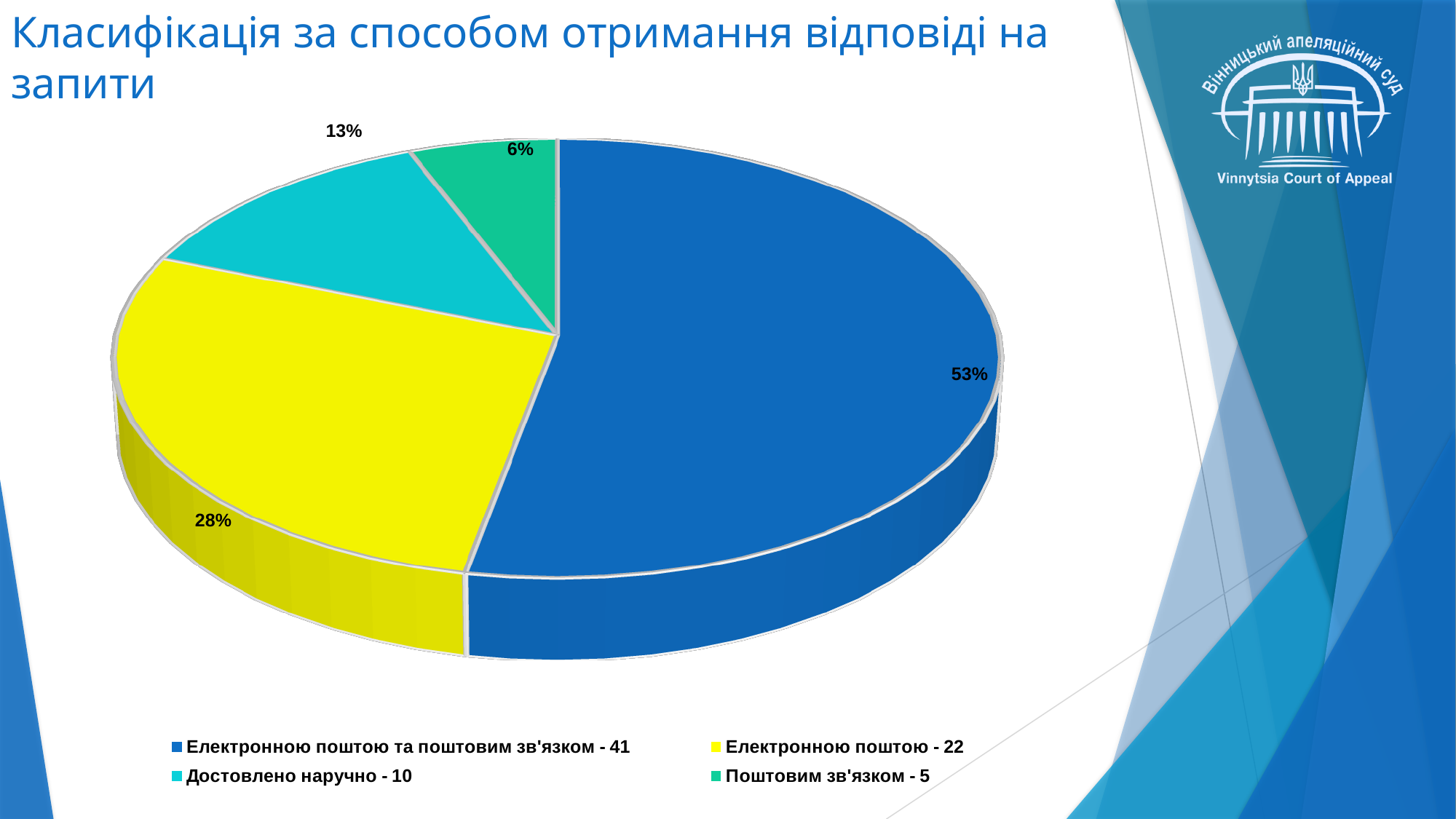
Which slice is larger: "Достовлено наручно - 10" or "Поштовим зв'язком - 5"? Достовлено наручно - 10 What kind of chart is shown on the slide? Pie chart What percentage share does the slice "Електронною поштою - 22" have? 28% What percentage share does the slice "Електронною поштою та поштовим зв'язком - 41" have? 53% What percentage share does the slice "Достовлено наручно - 10" have? 13% Which category has the smallest slice of the pie? Поштовим зв'язком - 5 What is the title of the slide containing the pie chart? Класифікація за способом отримання відповіді на запити How many categories does the pie chart show? 4 Which category has the largest slice of the pie? Електронною поштою та поштовим зв'язком - 41 What colour is the slice labelled 28%? Yellow What is the difference in percentage points between the "Електронною поштою та поштовим зв'язком - 41" slice and the "Електронною поштою - 22" slice? 25